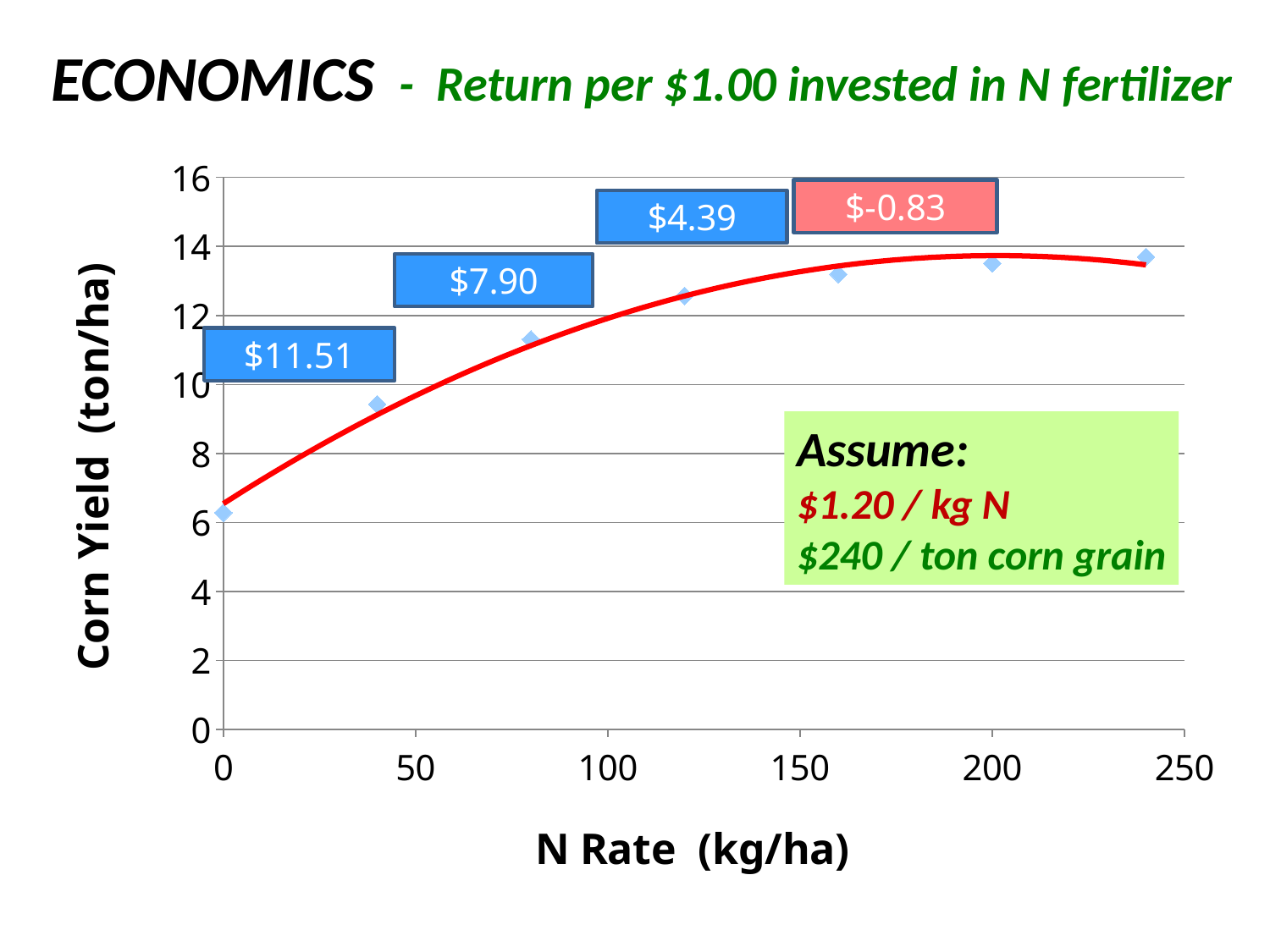
Is the corn yield at an N rate of 80 kg/ha greater or less than 10 ton/ha? greater Is the corn yield at an N rate of 40 kg/ha greater or less than 8 ton/ha? greater Is the corn yield at an N rate of 160 kg/ha greater or less than 14 ton/ha? less What kind of chart is shown on the slide? scatter chart with a fitted curve What return per $1.00 invested is shown in the red box on the chart? $-0.83 Does corn yield generally rise or fall as N rate increases from 0 to 160 kg/ha? rise How many data points are plotted on the chart? 7 Which has the higher corn yield, an N rate of 40 kg/ha or 120 kg/ha? 120 kg/ha Which N rate has the lowest corn yield? 0 kg/ha What is the label of the y axis? Corn Yield (ton/ha)